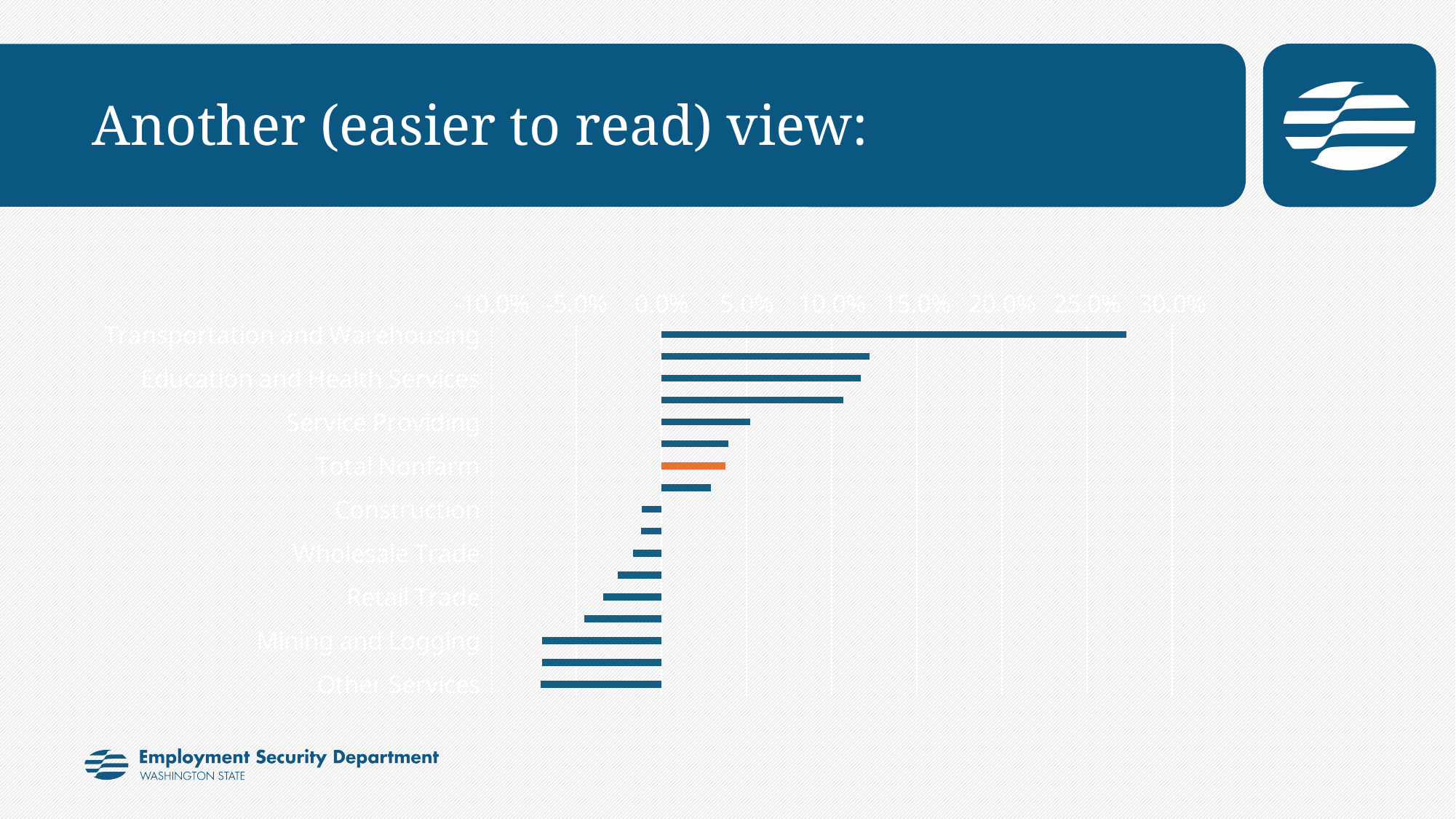
Is the value for Transportation and Warehousing greater or less than 25.0%? greater Which is larger, the value for Total Nonfarm or the value for Construction? Total Nonfarm Is the value for Construction greater or less than 0.0%? less Which is larger, the value for Transportation and Warehousing or the value for Education and Health Services? Transportation and Warehousing Which category's bar is coloured orange instead of blue? Total Nonfarm Which category has the highest value in the chart? Transportation and Warehousing Is the value for Retail Trade greater or less than -5.0%? greater What kind of chart is shown on the slide? bar chart Do the bar values rise or fall going from the top of the chart to the bottom? fall